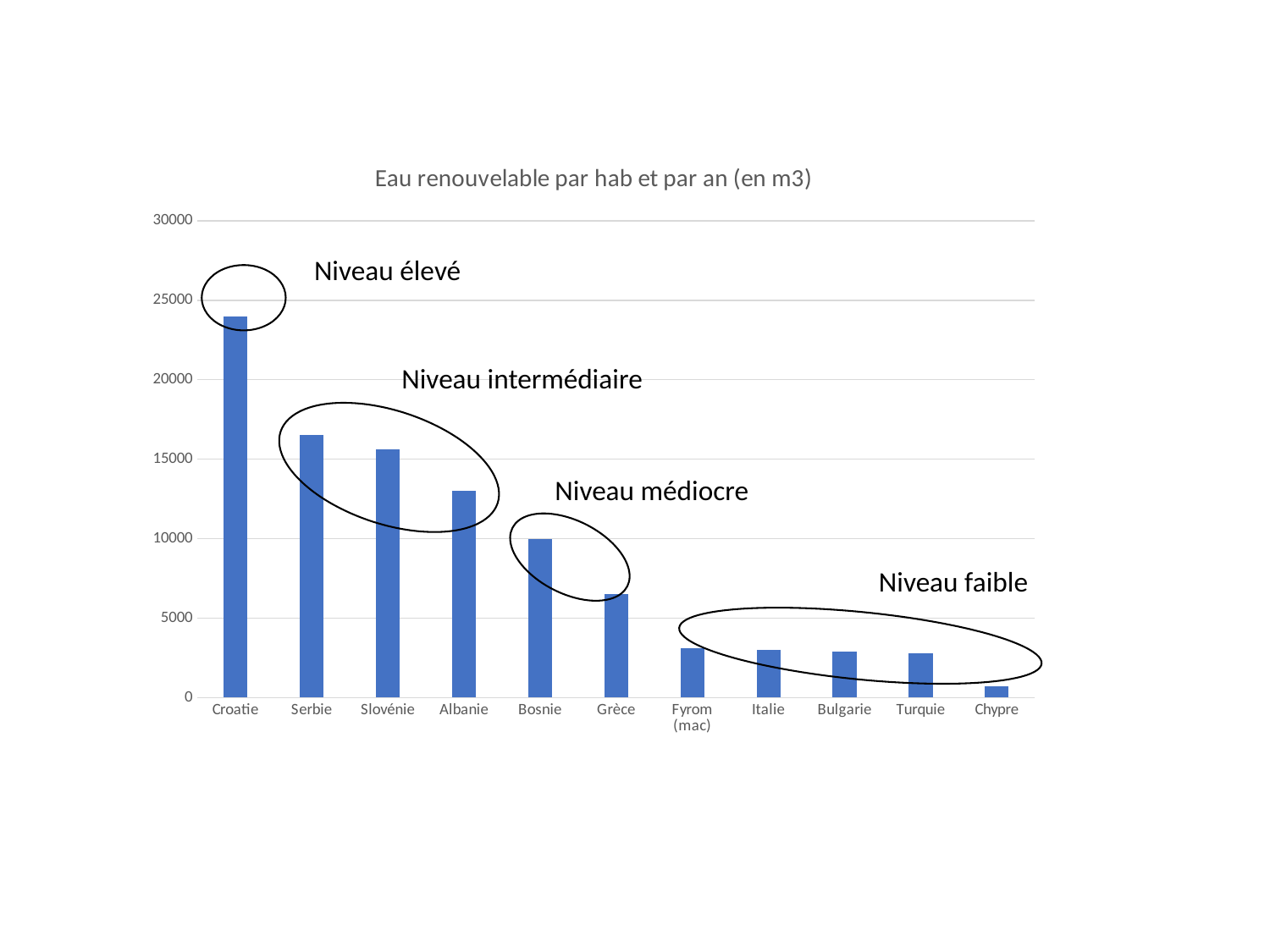
Is the value for Serbie greater or less than 15000? greater How many countries are plotted on the chart? 11 Which country has the lowest value? Chypre Do the values rise or fall from left to right along the x axis? Fall Is the value for Grèce greater or less than 5000? greater What kind of chart is shown on the slide? Bar chart Which is larger, the value for Serbie or the value for Albanie? Serbie What is the title of the chart? Eau renouvelable par hab et par an (en m3) Which country has the highest value? Croatie Is the value for Croatie greater or less than 25000? less